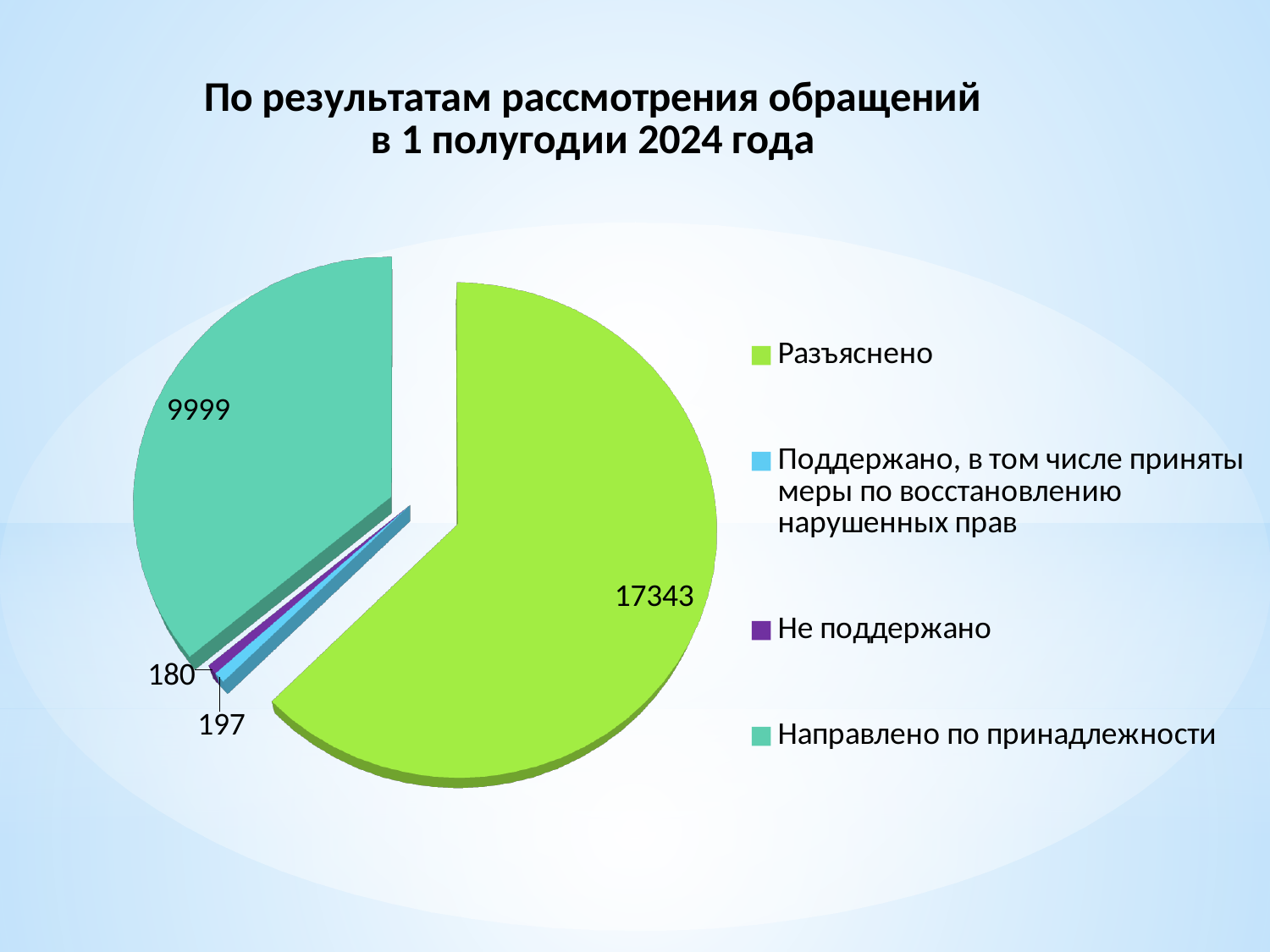
Which category has the smallest slice of the pie? Не поддержано What is the difference between the 'Разъяснено' value and the 'Направлено по принадлежности' value? 7344 What is the value for the 'Не поддержано' slice? 180 What is the value for the 'Направлено по принадлежности' slice? 9999 What type of chart is shown on the slide? Pie chart Which category has the largest slice of the pie? Разъяснено What is the value for the 'Поддержано, в том числе приняты меры по восстановлению нарушенных прав' slice? 197 Which is larger: the value for 'Разъяснено' or the value for 'Направлено по принадлежности'? Разъяснено What is the title of the chart on the slide? По результатам рассмотрения обращений в 1 полугодии 2024 года What is the value for the 'Разъяснено' slice? 17343 How many categories does the legend list? 4 What is the difference between the 'Поддержано' value and the 'Не поддержано' value? 17